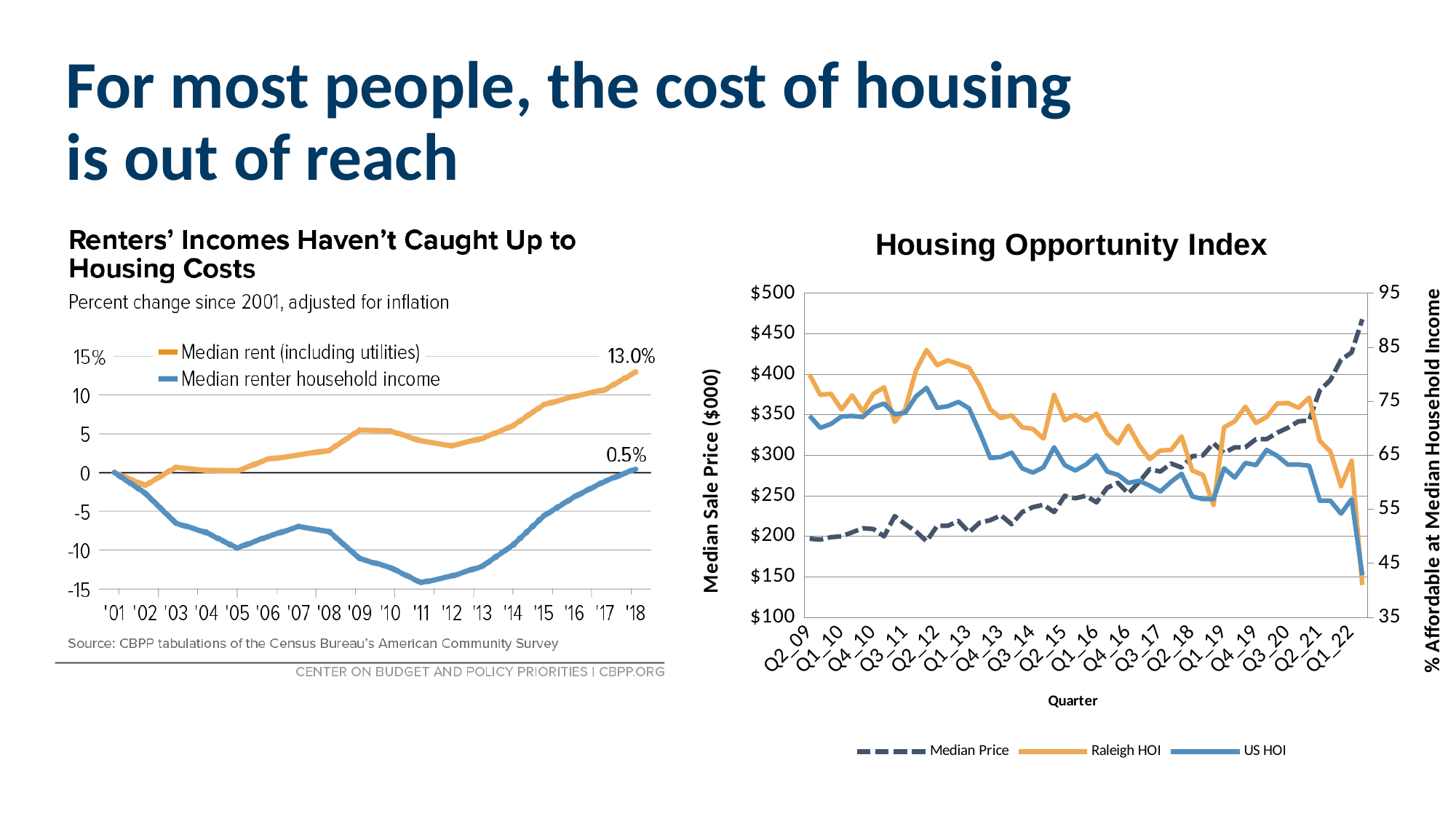
In the chart 'Renters' Incomes Haven't Caught Up to Housing Costs', does Median rent rise or fall from '12 to '18? rise In the 'Housing Opportunity Index' chart, what is the label of the right-hand vertical axis? % Affordable at Median Household Income In the chart 'Renters' Incomes Haven't Caught Up to Housing Costs', is the Median renter household income value for '11 greater or less than -10? less In the chart 'Renters' Incomes Haven't Caught Up to Housing Costs', what is the difference between the Median rent and Median renter household income values labelled for '18? 12.5 percentage points What kind of chart is the 'Housing Opportunity Index' chart? line chart In the 'Housing Opportunity Index' chart, does the Median Price series generally rise or fall from Q2_09 to the end of the series? rise How many series does the legend of the 'Housing Opportunity Index' chart list? 3 In the chart 'Renters' Incomes Haven't Caught Up to Housing Costs', which series has the larger value in '18, Median rent or Median renter household income? Median rent (including utilities) In the chart 'Renters' Incomes Haven't Caught Up to Housing Costs', what is the value for Median renter household income in '18? 0.5% In the chart 'Renters' Incomes Haven't Caught Up to Housing Costs', what is the value for Median rent (including utilities) in '18? 13.0% How many series does the legend of the chart 'Renters' Incomes Haven't Caught Up to Housing Costs' list? 2 In the chart 'Renters' Incomes Haven't Caught Up to Housing Costs', in which year does Median renter household income reach its lowest point? '11